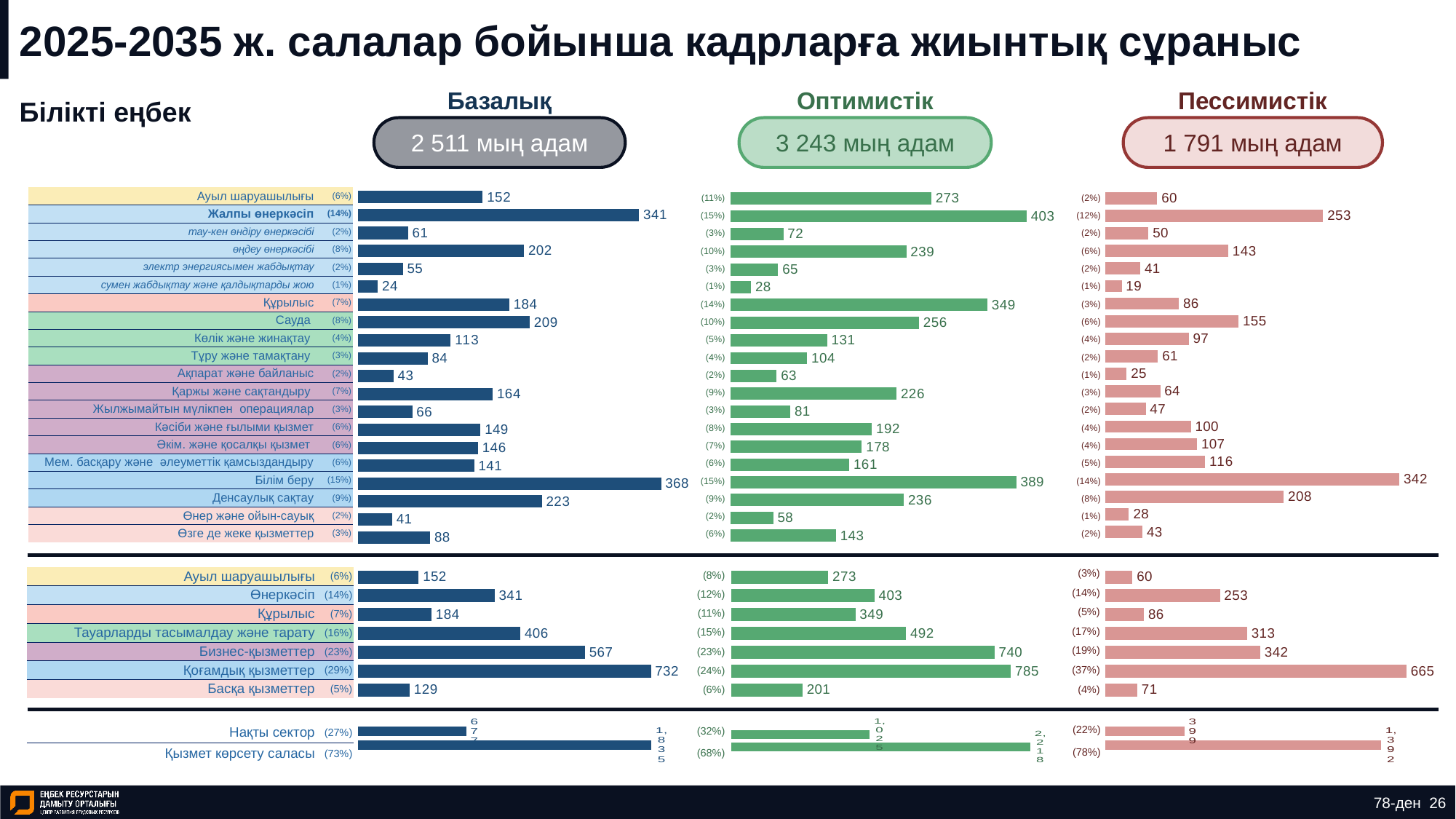
What total is shown in the header for the Оптимистік scenario? 3 243 мың адам In the Базалық chart, which category has the lowest value? сумен жабдықтау және қалдықтарды жою In the Оптимистік chart, which is larger: Құрылыс or Сауда? Құрылыс In the Пессимистік chart, what is the value for Денсаулық сақтау? 208 In the Базалық chart, what is the difference between Білім беру and Денсаулық сақтау? 145 In the middle section of the Пессимистік chart, what is the value for Қоғамдық қызметтер? 665 In the Оптимистік chart, what is the value for Ауыл шаруашылығы? 273 How many categories are shown in the top section of the Базалық chart? 20 What kind of chart is used for the Базалық scenario? bar chart In the Базалық chart, what is the value for Білім беру? 368